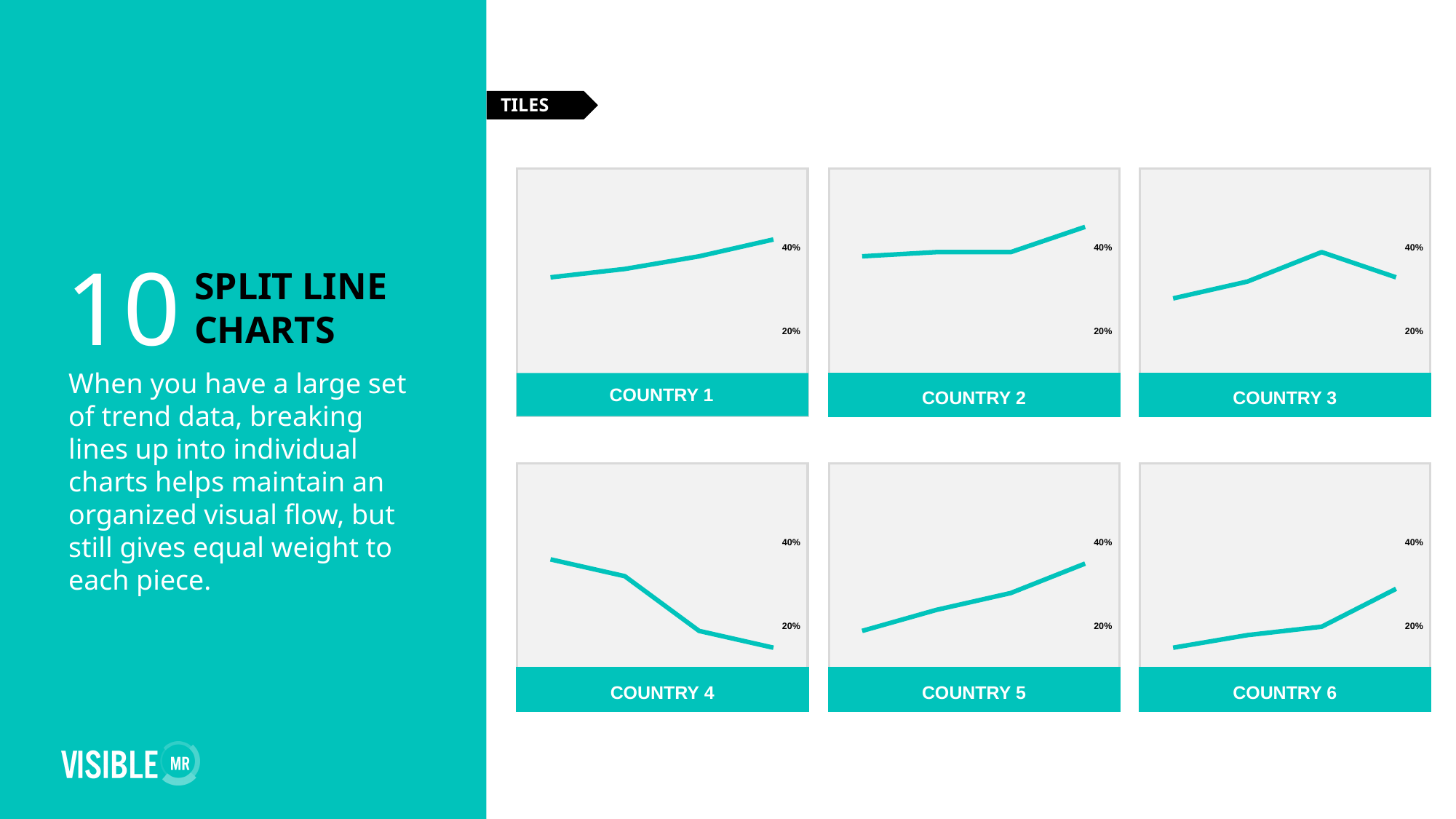
In the Country 1 chart, is the first (leftmost) value greater or less than 40%? less In the Country 6 chart, is the first (leftmost) value greater or less than 20%? less In the Country 4 chart, is the last (rightmost) value greater or less than 20%? less What label appears in the tag above the charts on the slide? TILES In the Country 1 chart, do the values rise or fall from left to right? rise In the Country 6 chart, do the values rise or fall from left to right? rise What kind of chart is shown in the Country 1 tile? line chart In the Country 4 chart, do the values rise or fall from left to right? fall How many country tiles (charts) are shown on the slide? 6